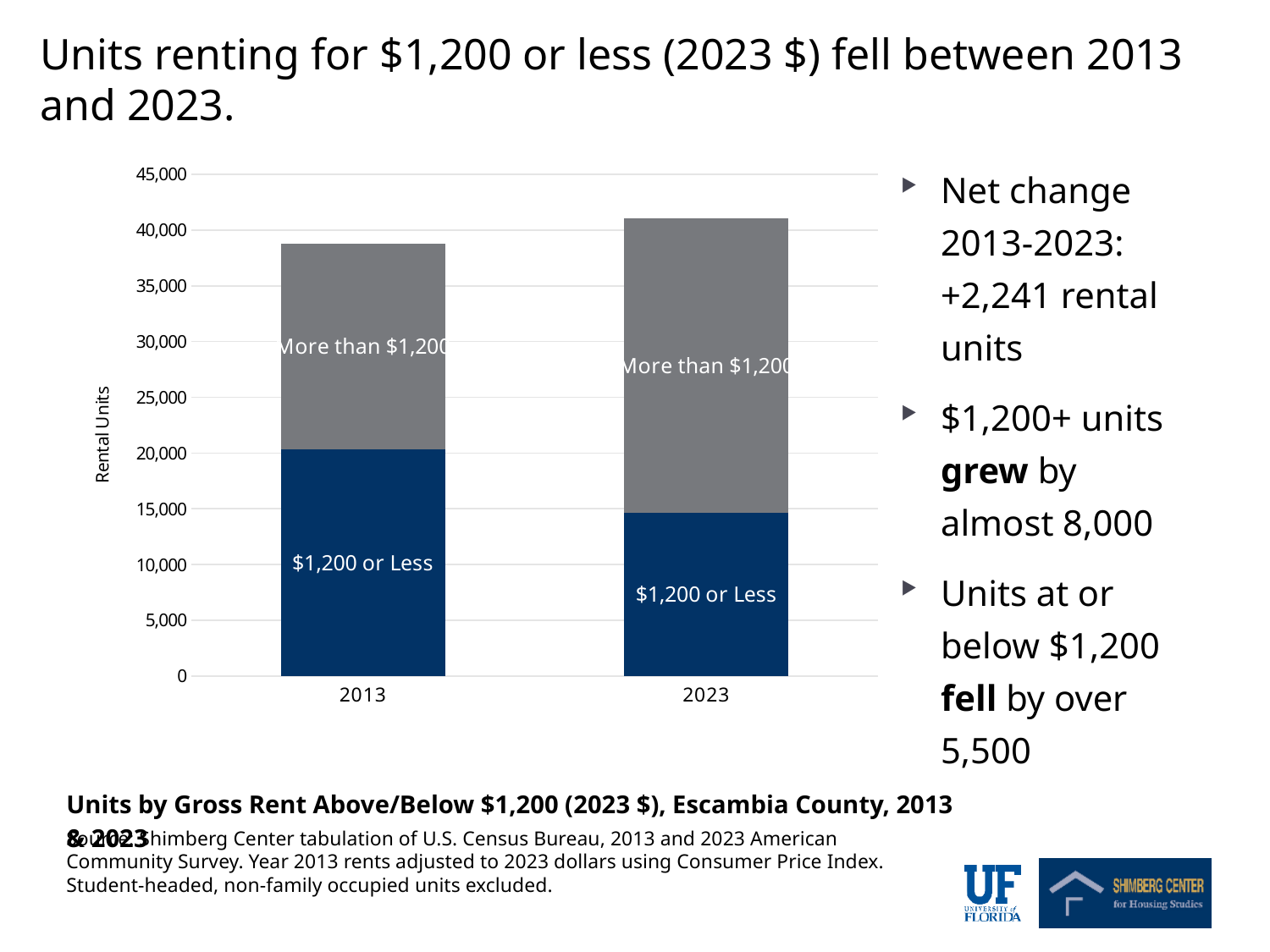
How many rent segments are stacked in each bar of the chart? 2 What is the label on the vertical axis of the chart? Rental Units Which year has more '$1,200 or Less' rental units, 2013 or 2023? 2013 Is the value for '$1,200 or Less' units in 2013 greater or less than 15,000? greater What kind of chart is shown on the slide? Stacked bar chart Which year has the larger total number of rental units, 2013 or 2023? 2023 How many years (categories) are shown on the x axis of the chart? 2 Which year has more 'More than $1,200' rental units, 2013 or 2023? 2023 Is the total height of the 2013 bar greater or less than 40,000? less Is the total height of the 2023 bar greater or less than 40,000? greater Does the number of '$1,200 or Less' units rise or fall from 2013 to 2023? fall